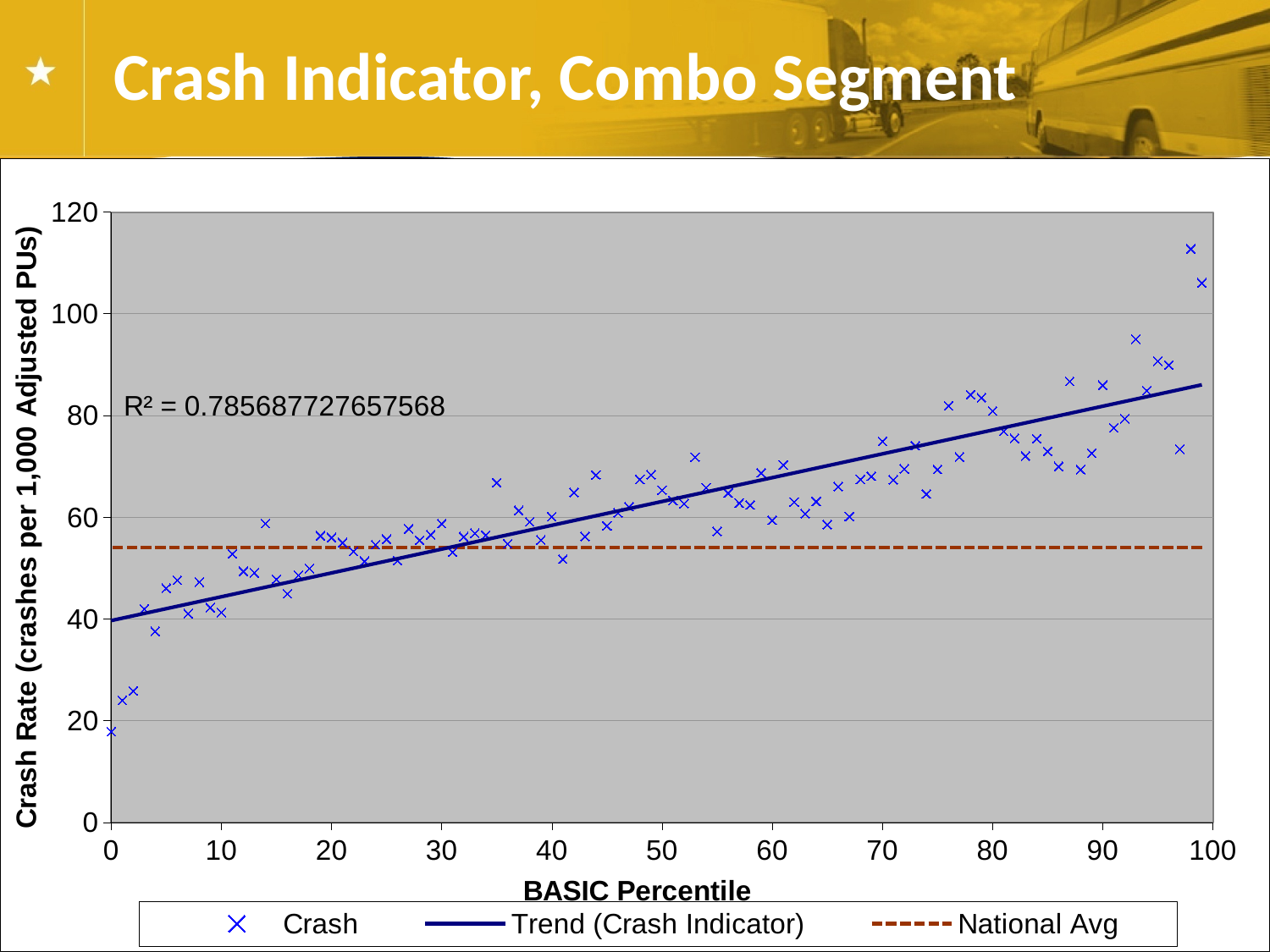
Does the Trend (Crash Indicator) line rise or fall as BASIC Percentile increases? Rises Is the National Avg line greater or less than 50 crashes per 1,000 Adjusted PUs? greater Is the Trend (Crash Indicator) line at BASIC Percentile 0 greater or less than 60? less Is the Trend (Crash Indicator) line at BASIC Percentile 100 greater or less than 80? greater What is the label of the x axis? BASIC Percentile What kind of chart is shown on the slide? Scatter chart What are the three entries in the chart legend? Crash, Trend (Crash Indicator), National Avg Which is larger at BASIC Percentile 90: the Trend (Crash Indicator) line or the National Avg line? Trend (Crash Indicator) Which is larger at BASIC Percentile 10: the Trend (Crash Indicator) line or the National Avg line? National Avg What R² value is printed on the chart? R² = 0.785687727657568 How many series does the legend list? 3